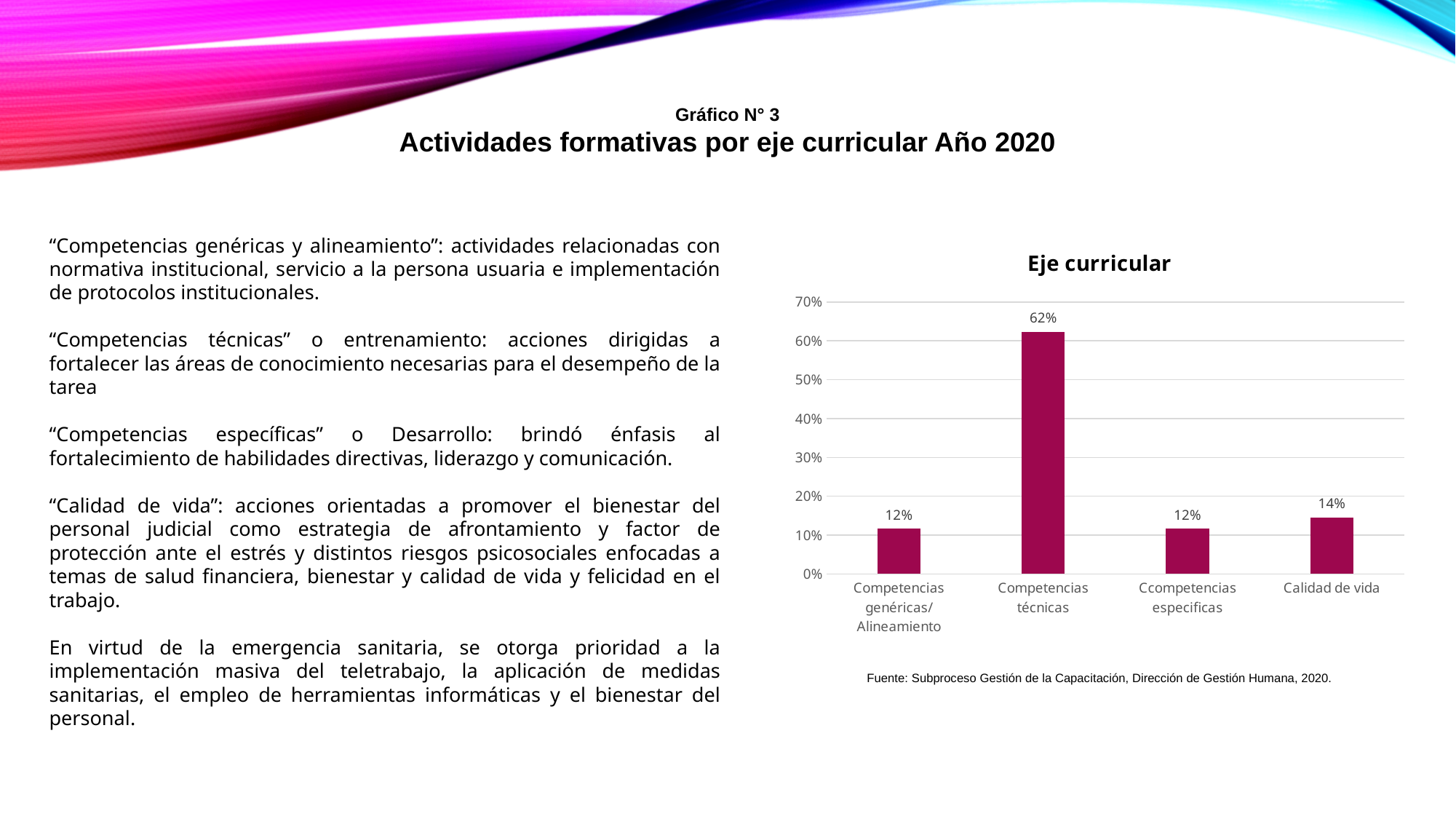
What is the difference between Calidad de vida and Ccompetencias especificas? 2% What is the value for Competencias genéricas/Alineamiento? 12% What is the value for Competencias técnicas? 62% What kind of chart is shown? Bar chart What is the title of the chart? Eje curricular What is the highest value shown on the y axis? 70% Which category has the highest value? Competencias técnicas How many categories are shown on the x axis? 4 Which is larger, Calidad de vida or Ccompetencias especificas? Calidad de vida Is the value for Competencias técnicas greater or less than 50%? greater What is the difference between Competencias técnicas and Calidad de vida? 48% What is the value for Calidad de vida? 14%